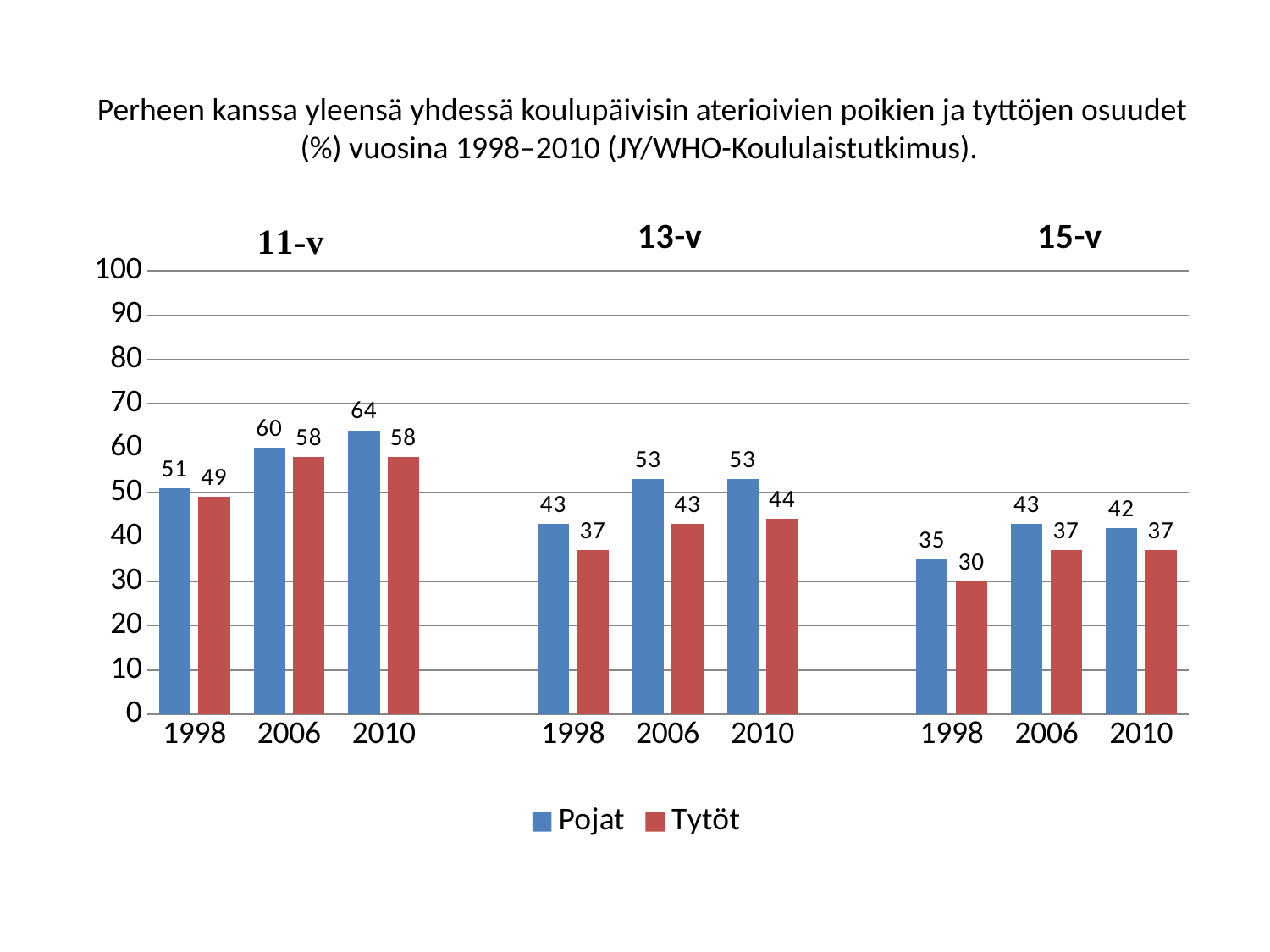
What is the value for Tytöt in the 15-v group in 1998? 30 What is the difference between the Pojat values for 11-v and 15-v in 2010? 22 Which is larger in the 15-v group in 2006: Pojat or Tytöt? Pojat What is the value for Pojat in the 11-v group in 2010? 64 Which colour represents Tytöt in the chart? Red What is the value for Pojat in the 13-v group in 2006? 53 How do the Pojat values change across 1998, 2006 and 2010 in the 11-v group? They rise Which bar has the highest value on the chart? Pojat, 11-v, 2010 What kind of chart is shown on the slide? Bar chart How many series does the legend list? 2 Which bar has the lowest value on the chart? Tytöt, 15-v, 1998 What is the difference between Pojat and Tytöt in the 13-v group in 1998? 6